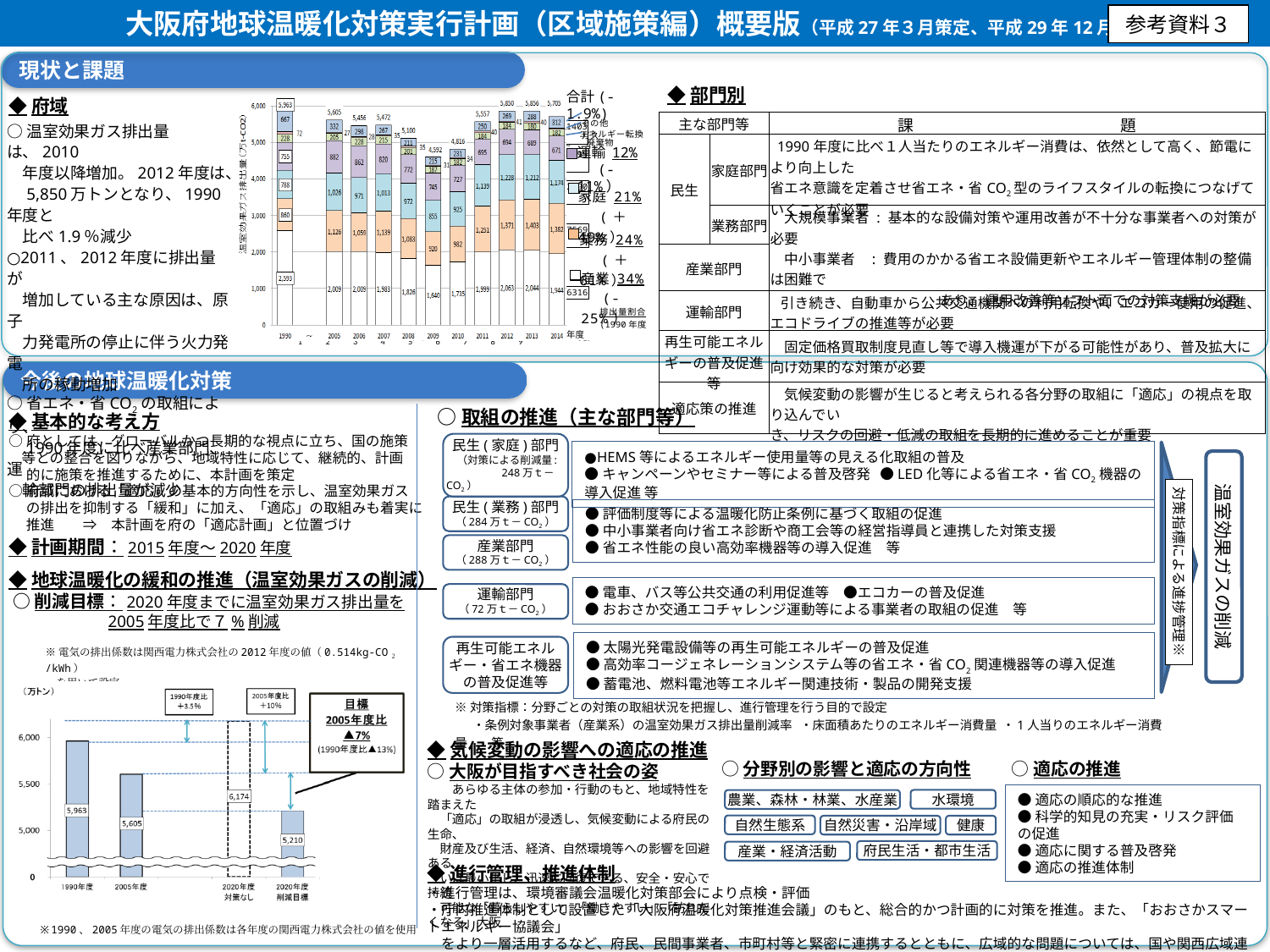
In the bottom-left bar chart, which category has the highest value? 2020年度 対策なし In the top stacked bar chart of greenhouse gas emissions, what is the total for 2009? 4,592 In the top stacked bar chart of greenhouse gas emissions, which year has the lowest total? 2009 What kind of chart is the bottom-left chart? Bar chart In the top stacked bar chart of greenhouse gas emissions, what is the total for 2012? 5,850 In the bottom-left bar chart, how many bars are plotted? 4 In the top stacked bar chart of greenhouse gas emissions, what is the difference between the 1990 total and the 2005 total? 358 In the bottom-left bar chart, what is the value for 1990年度? 5,963 In the top stacked bar chart of greenhouse gas emissions, which total is larger, 1990 or 2014? 1990 In the bottom-left bar chart, which category has the lowest value? 2020年度 削減目標 In the bottom-left bar chart, what is the difference between the 2020年度 対策なし value and the 2020年度 削減目標 value? 964 In the bottom-left bar chart, what is the value for 2020年度 削減目標? 5,210